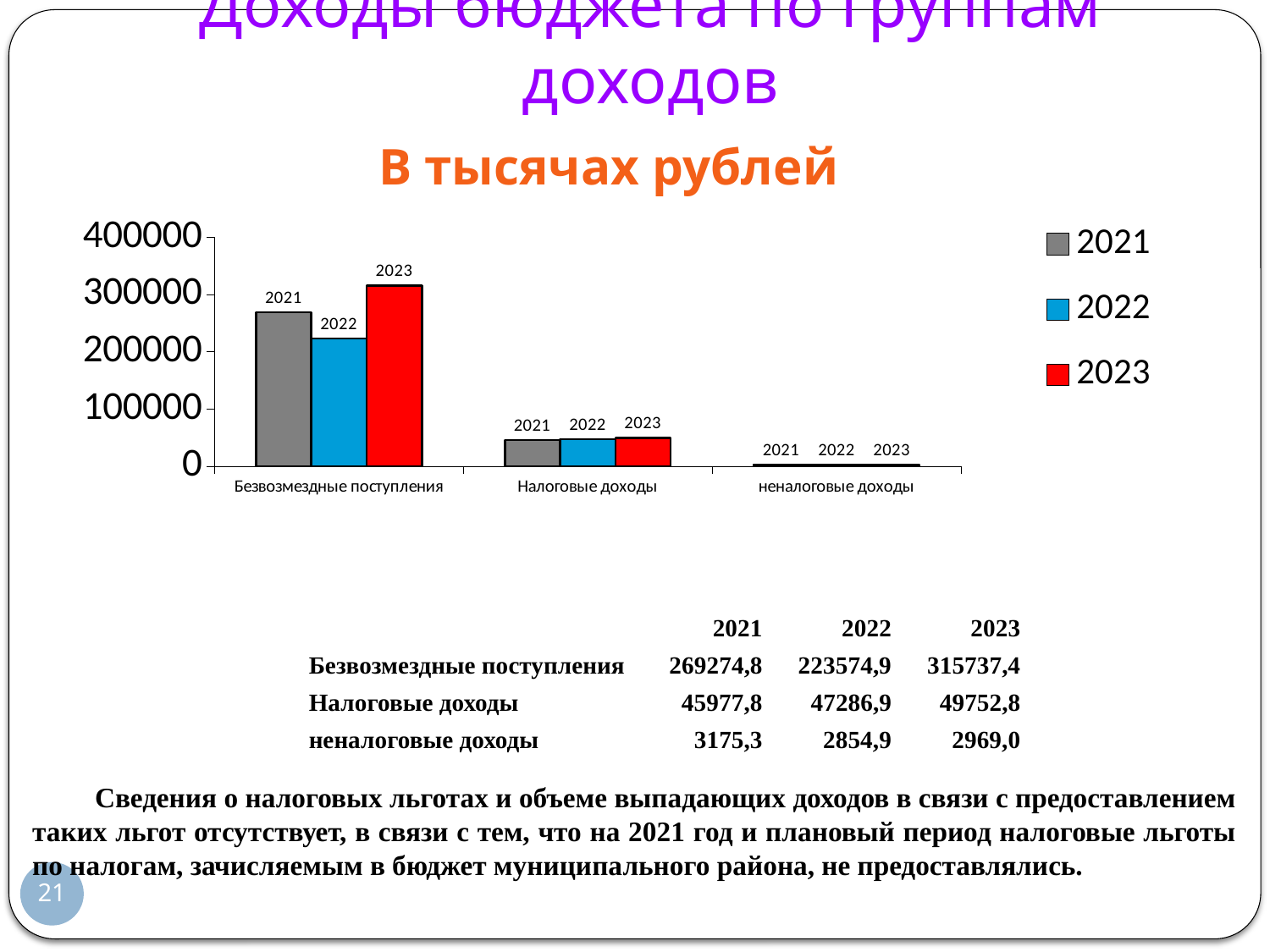
Which category has the highest values in the chart? Безвозмездные поступления What is the value for Налоговые доходы in 2022? 47286,9 Is the value for Налоговые доходы in 2021 greater or less than 100000? less What colour represents the 2023 series in the chart? red Which category has the lowest values in the chart? неналоговые доходы Which is larger for Безвозмездные поступления: the 2021 value or the 2022 value? 2021 Is the value for Безвозмездные поступления in 2023 greater or less than 300000? greater What kind of chart is shown on the slide? bar chart What is the value for Безвозмездные поступления in 2023? 315737,4 What is the value for неналоговые доходы in 2021? 3175,3 How many categories are shown on the x axis of the chart? 3 How many series does the chart legend list? 3